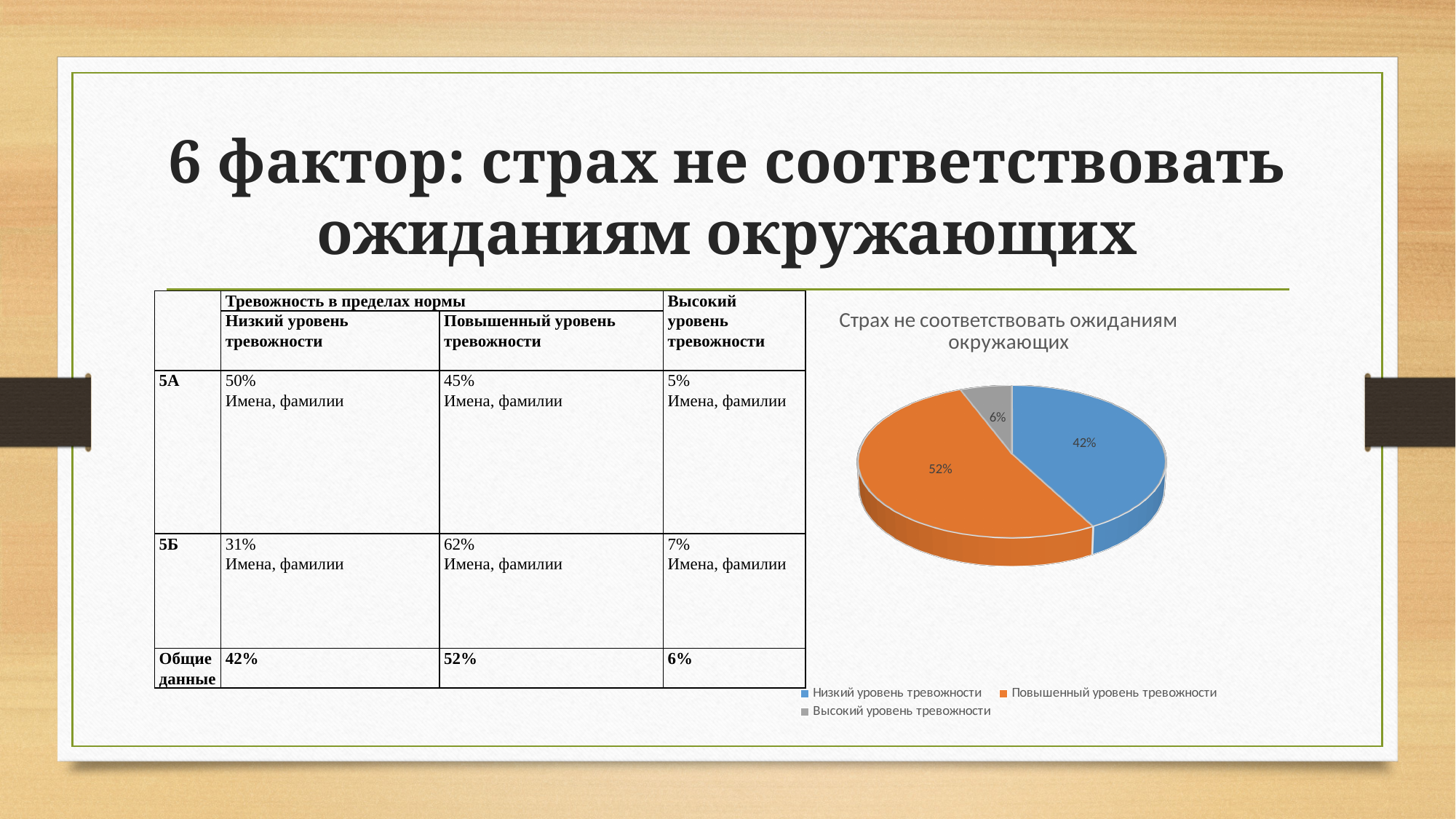
Which category has the smallest slice of the pie? Высокий уровень тревожности What is the difference between the shares of "Повышенный уровень тревожности" and "Низкий уровень тревожности"? 10% What share of the pie does "Высокий уровень тревожности" have? 6% What kind of chart is shown on the slide? pie chart How many slices does the pie chart have? 3 What colour is the slice for "Повышенный уровень тревожности"? orange What is the title of the pie chart? Страх не соответствовать ожиданиям окружающих What share of the pie does "Повышенный уровень тревожности" have? 52% Which is larger: the slice for "Низкий уровень тревожности" or the slice for "Высокий уровень тревожности"? Низкий уровень тревожности What share of the pie does "Низкий уровень тревожности" have? 42% How many entries does the legend of the pie chart list? 3 Which category has the largest slice of the pie? Повышенный уровень тревожности